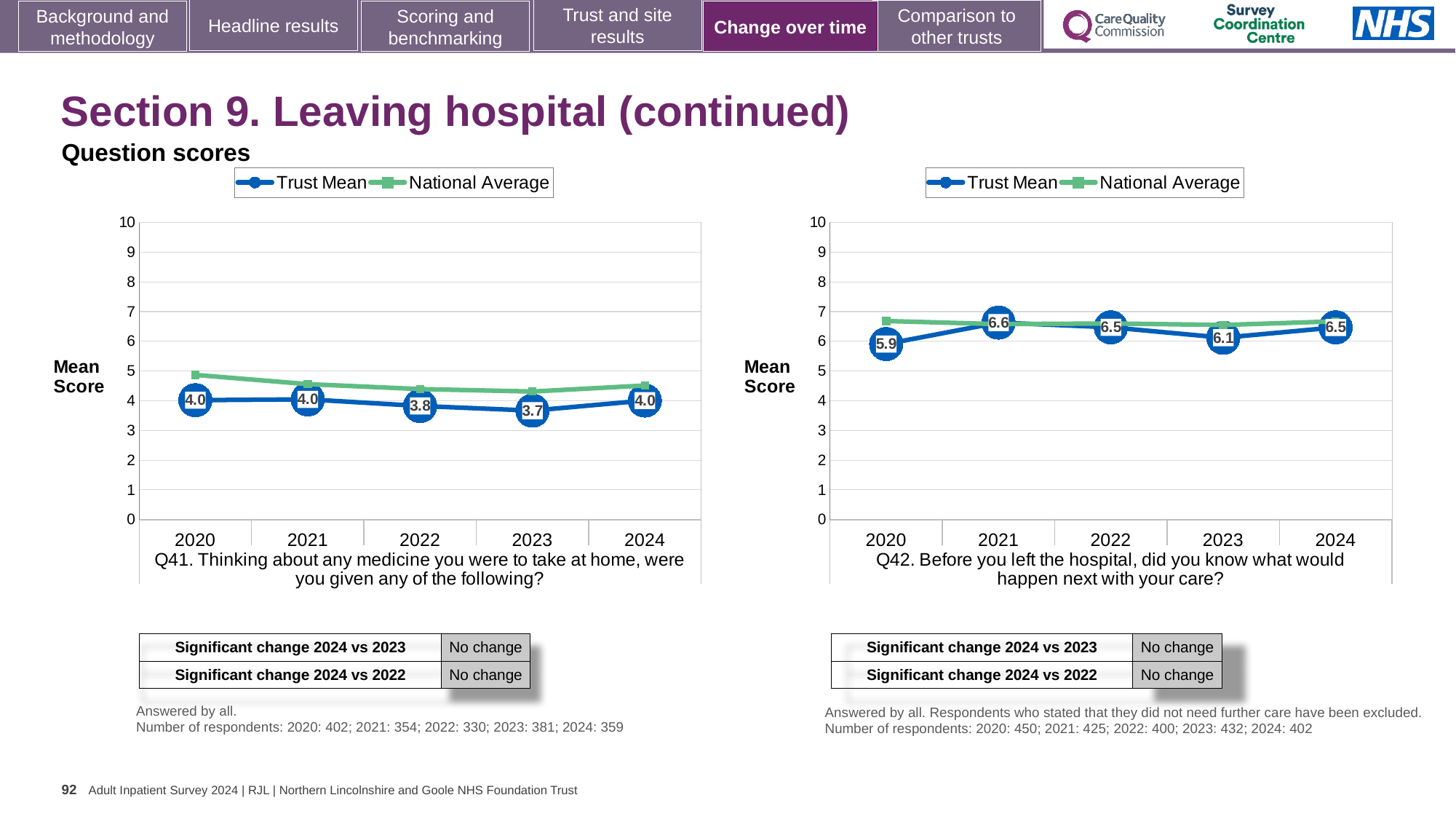
How many years are plotted on the x axis of the Q42 chart (right)? 5 In the Q42 chart (right), what is the Trust Mean score for 2020? 5.9 In the Q42 chart (right), does the Trust Mean rise or fall from 2020 to 2021? Rise In the Q41 chart (left), is the Trust Mean score higher in 2022 or in 2023? 2022 In the Q42 chart (right), what is the difference between the Trust Mean scores for 2021 and 2020? 0.7 In the Q41 chart (left), what is the Trust Mean score for 2023? 3.7 In the Q41 chart (left), is the National Average for 2020 greater or less than 4? greater In the Q41 chart (left), which year has the lowest Trust Mean score? 2023 What type of chart is used for Q42 (right)? Line chart In the Q42 chart (right), which year has the highest Trust Mean score? 2021 What are the two series named in the legend of the Q42 chart (right)? Trust Mean and National Average How many series does the legend of the Q41 chart (left) list? 2